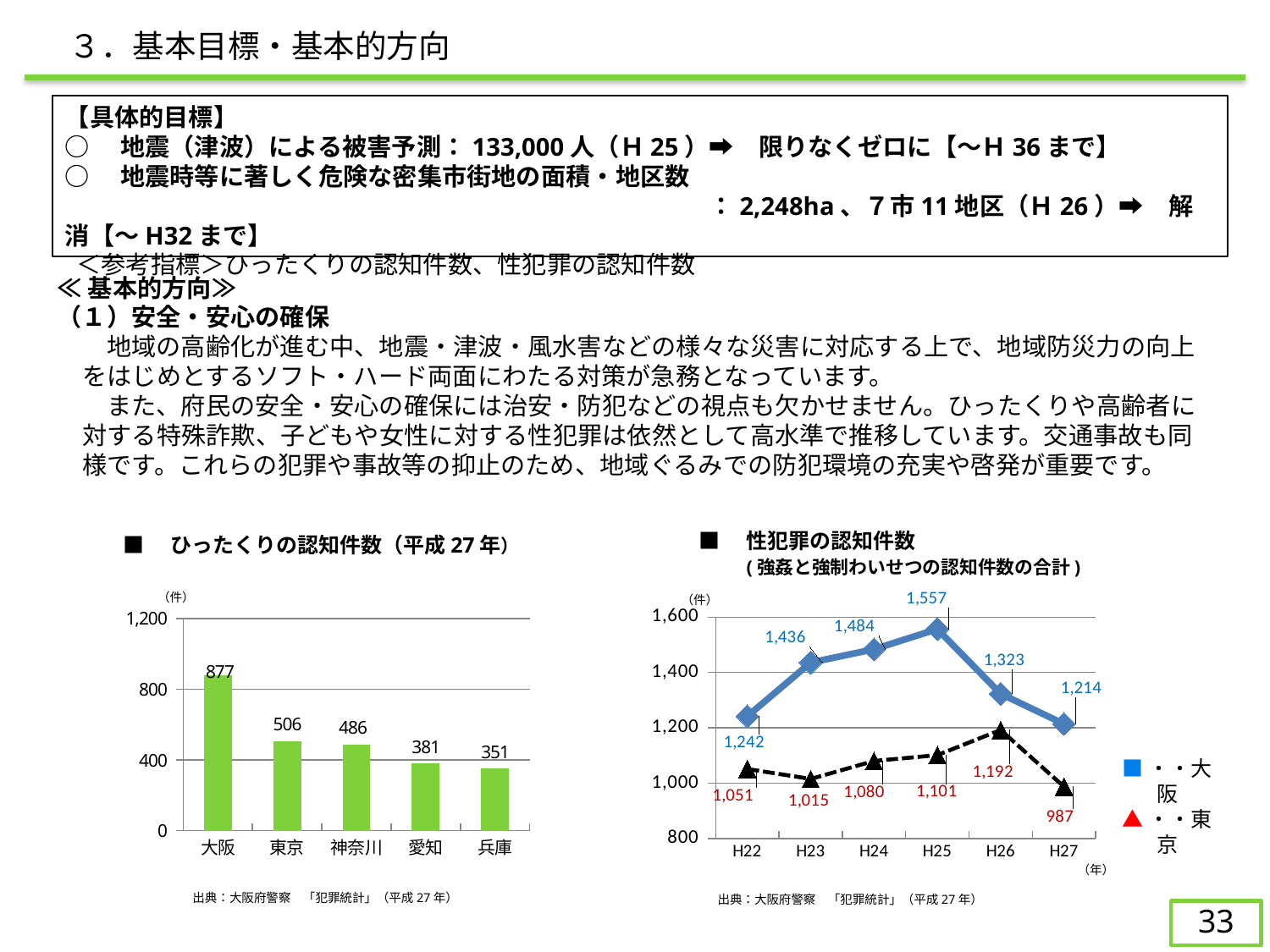
In the 性犯罪の認知件数 chart, in which year is the 大阪 value highest? H25 In the ひったくりの認知件数 chart, what is the value for 大阪? 877 In the 性犯罪の認知件数 chart, how many series does the legend list? 2 In the ひったくりの認知件数 chart, what is the difference between 大阪 and 東京? 371 In the 性犯罪の認知件数 chart, what is the value for 東京 in H27? 987 In the ひったくりの認知件数 chart, which prefecture has the lowest value? 兵庫 In the ひったくりの認知件数 chart, is the value for 愛知 greater or less than 400? less What kind of chart is the ひったくりの認知件数 chart? bar chart In the 性犯罪の認知件数 chart, what is the value for 大阪 in H25? 1,557 In the ひったくりの認知件数 chart, how many prefectures are shown? 5 In the 性犯罪の認知件数 chart, does the 大阪 value rise or fall from H25 to H27? fall In the 性犯罪の認知件数 chart, what is the difference between 大阪 and 東京 in H26? 131